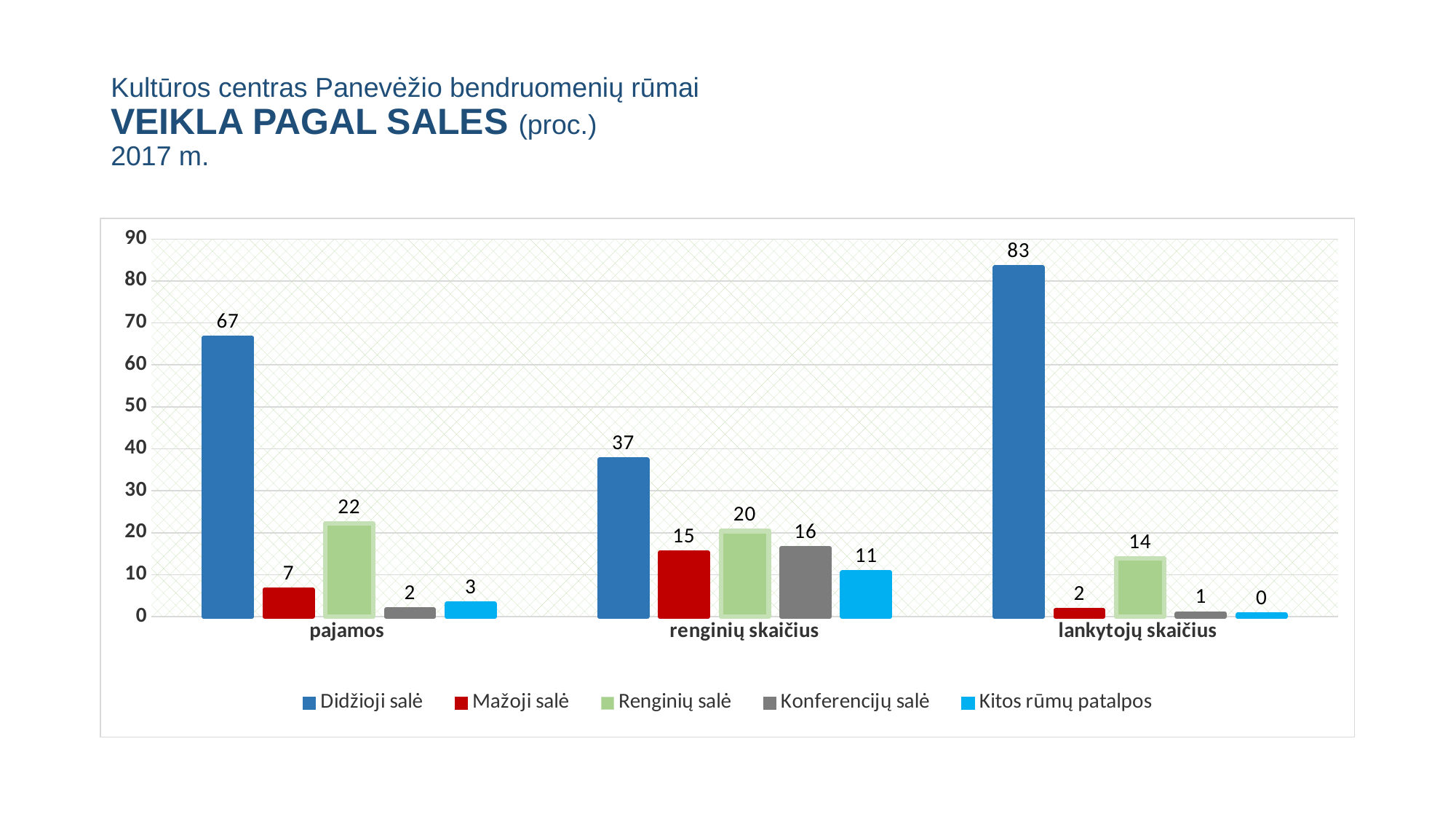
Which series has the highest value in the lankytojų skaičius category? Didžioji salė Is the value for Didžioji salė in renginių skaičius greater or less than 40? less How many series does the legend list? 5 Which series has the lowest value in the pajamos category? Konferencijų salė What is the value for Konferencijų salė in the renginių skaičius category? 16 How many categories are shown on the x axis? 3 Which colour represents Mažoji salė in the legend? red What kind of chart is shown on the slide? bar chart What is the value for Kitos rūmų patalpos in the lankytojų skaičius category? 0 What is the value for Didžioji salė in the pajamos category? 67 What is the difference between the Didžioji salė values for lankytojų skaičius and pajamos? 16 Which is larger: Renginių salė in pajamos or Renginių salė in renginių skaičius? Renginių salė in pajamos